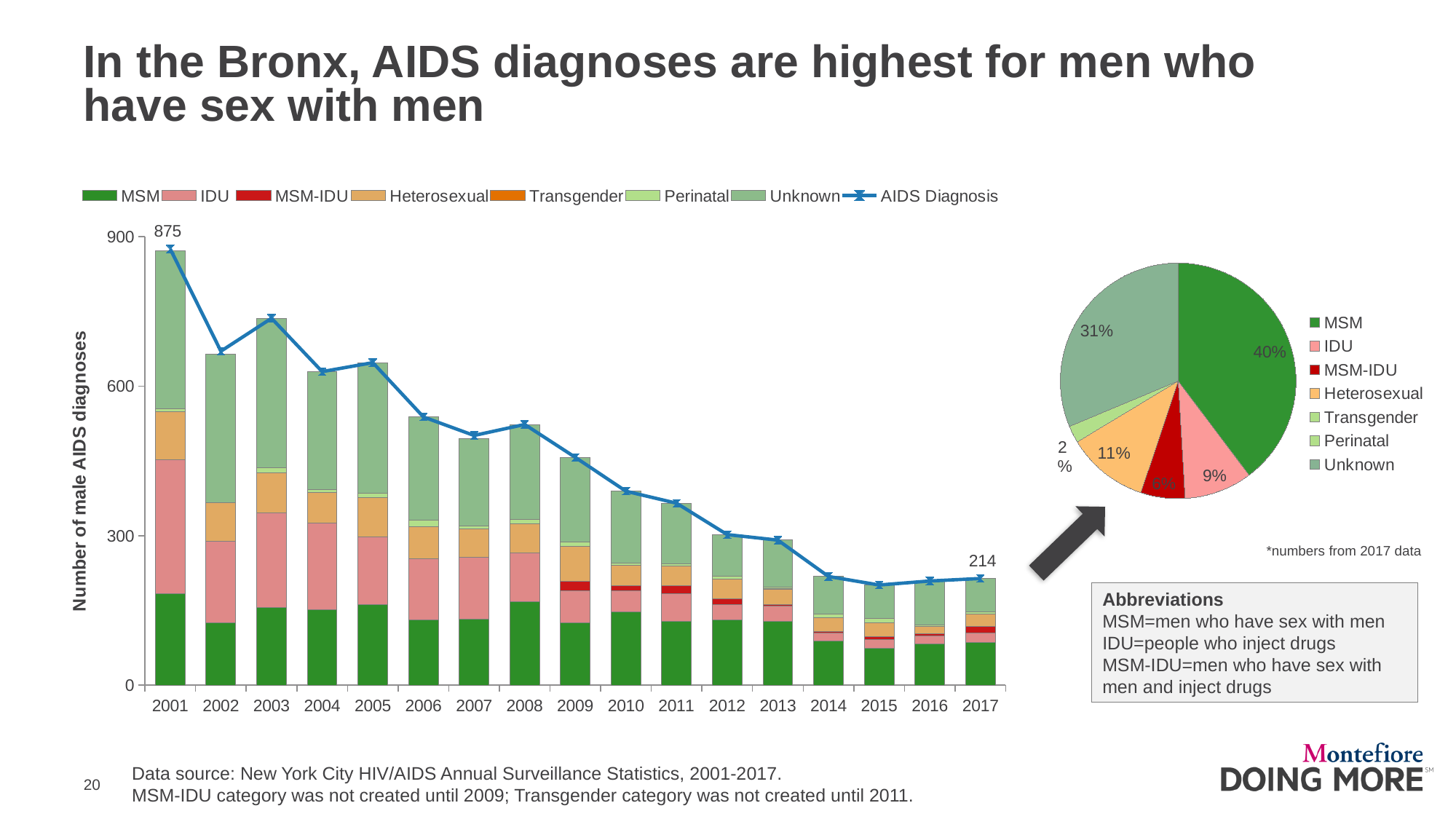
In the bar chart, what is the AIDS Diagnosis value labelled for 2001? 875 How many series does the legend of the bar chart list? 8 In the bar chart, does the AIDS Diagnosis line generally rise or fall from 2001 to 2017? fall In the bar chart, how many years are shown on the x axis? 17 In the pie chart, what share is MSM? 40% In the bar chart, by how much did the labelled AIDS Diagnosis value fall from 2001 to 2017? 661 In the bar chart, is the AIDS Diagnosis value for 2002 greater or less than 600? greater In the pie chart, which is larger, Heterosexual or IDU? Heterosexual In the bar chart, what is the AIDS Diagnosis value labelled for 2017? 214 In the bar chart, is the AIDS Diagnosis value for 2014 greater or less than 300? less In the pie chart, what share is Unknown? 31% In the pie chart, which category has the largest slice? MSM